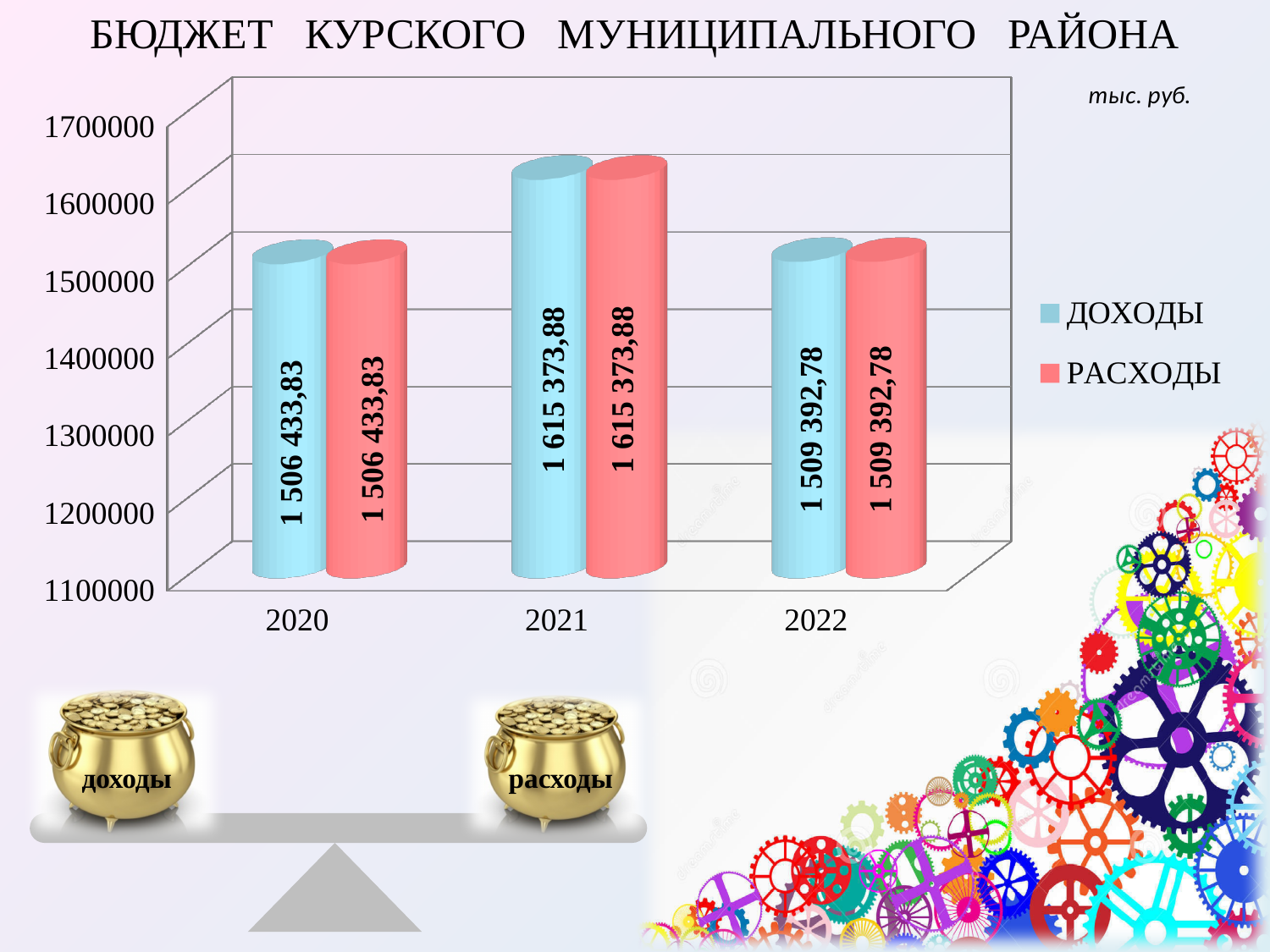
What is the value of ДОХОДЫ for 2020? 1 506 433,83 What is the value of РАСХОДЫ for 2021? 1 615 373,88 How many series does the legend list? 2 What is the difference between ДОХОДЫ in 2021 and ДОХОДЫ in 2020? 108 940,05 How many years are shown on the x axis? 3 What is the value of ДОХОДЫ for 2022? 1 509 392,78 In which year is РАСХОДЫ the lowest? 2020 What kind of chart is shown on the slide? bar chart Is the value of РАСХОДЫ for 2021 greater or less than 1600000? greater In which year is ДОХОДЫ the highest? 2021 What unit is indicated for the chart values? тыс. руб. Which is larger: ДОХОДЫ in 2022 or ДОХОДЫ in 2020? 2022